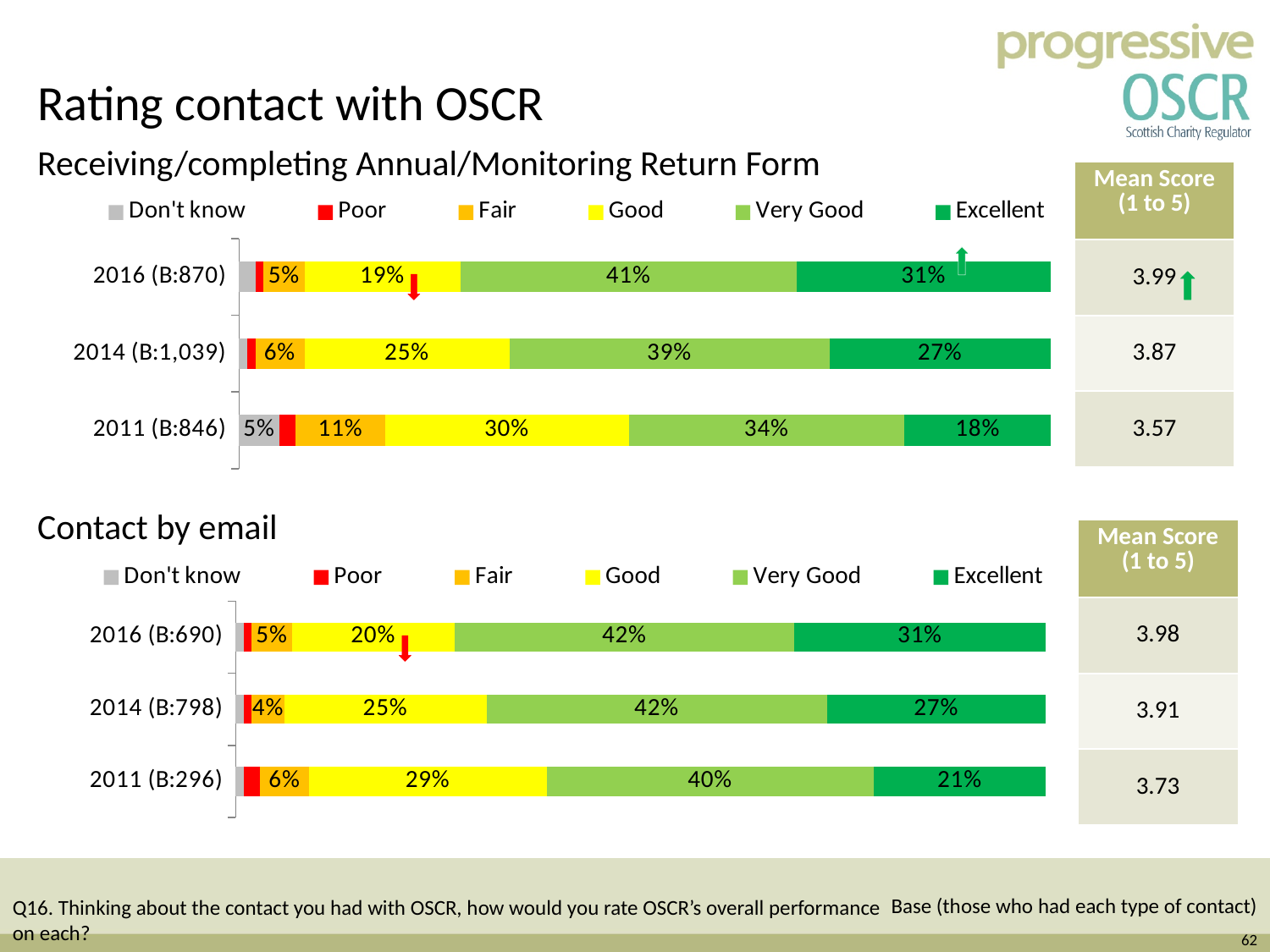
In the 'Receiving/completing Annual/Monitoring Return Form' chart, how many series does the legend list? 6 In the 'Contact by email' chart, what percentage rated it Excellent in 2014 (B:798)? 27% In the 'Contact by email' chart, which year has the lowest Excellent percentage? 2011 (B:296) In the 'Contact by email' chart, what is the difference between the Fair percentage in 2011 (B:296) and in 2014 (B:798)? 2% In the 'Receiving/completing Annual/Monitoring Return Form' chart, what is the difference between the Good percentage in 2014 (B:1,039) and in 2016 (B:870)? 6% In the 'Receiving/completing Annual/Monitoring Return Form' chart, which year has the highest Excellent percentage? 2016 (B:870) In the 'Receiving/completing Annual/Monitoring Return Form' chart, what percentage rated it Excellent in 2011 (B:846)? 18% In the 'Contact by email' chart, how many year categories are shown? 3 In the 'Receiving/completing Annual/Monitoring Return Form' chart, what percentage rated it Very Good in 2016 (B:870)? 41% In the 'Contact by email' chart, what percentage rated it Good in 2011 (B:296)? 29% What type of chart is the 'Contact by email' chart? Stacked bar chart In the 'Contact by email' chart, is the Very Good percentage larger in 2016 (B:690) or in 2011 (B:296)? 2016 (B:690)